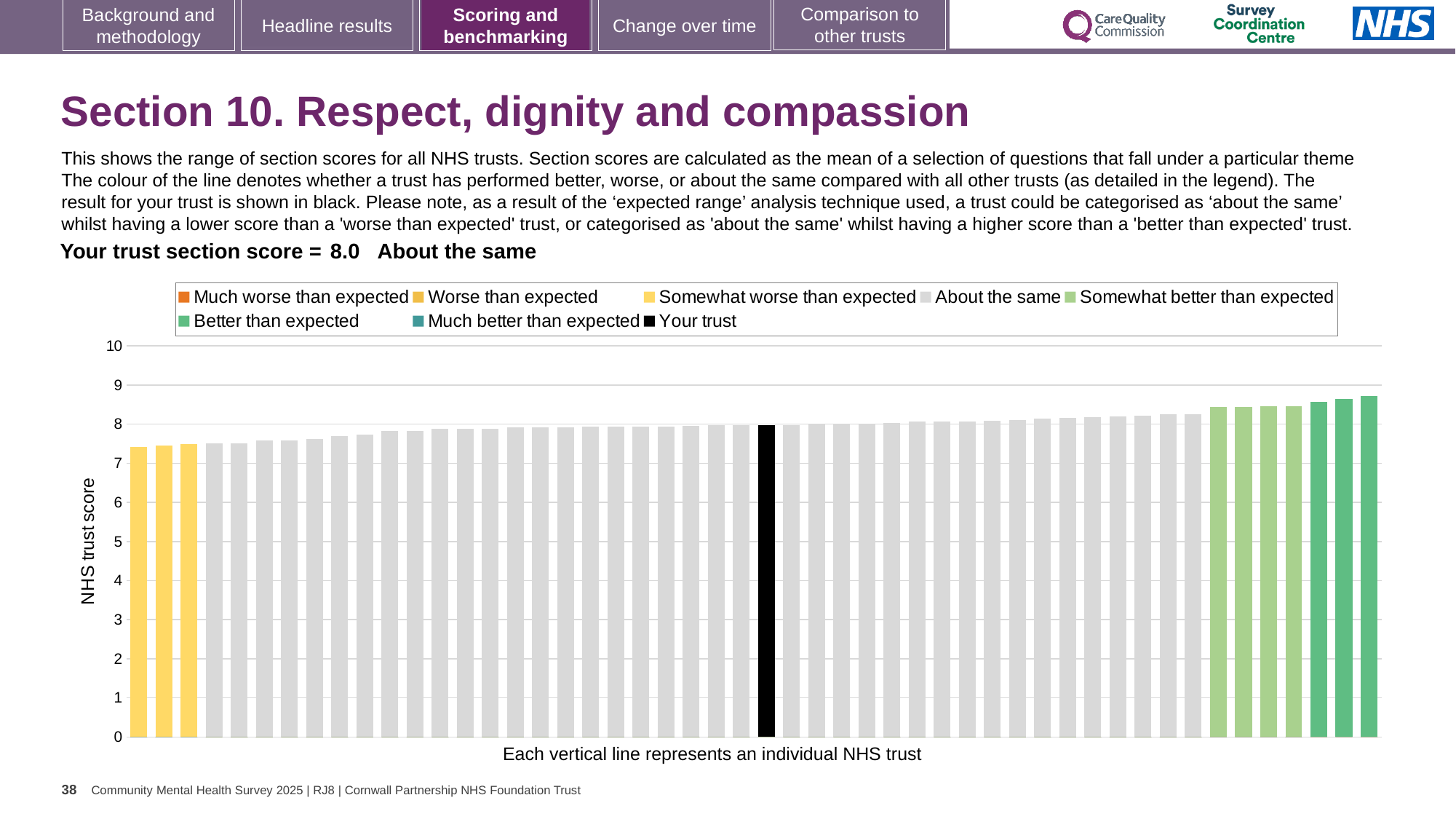
How many bars are coloured as 'Somewhat better than expected' (light green)? 4 Which category is your trust placed in for this section? About the same Is the value of the rightmost (highest) bar greater or less than 8? greater How many entries does the chart legend list? 8 Is the value of the leftmost (lowest) bar greater or less than 8? less Do the bar values rise or fall from left to right along the x axis? rise What kind of chart is shown on the slide? bar chart What is the label on the vertical axis of the chart? NHS trust score Which legend category do the highest-scoring bars on the chart belong to? Better than expected What is the section score for your trust shown on the slide? 8.0 Is the value for your trust greater or less than 5? greater How many bars are coloured as 'Worse than expected' (yellow)? 0